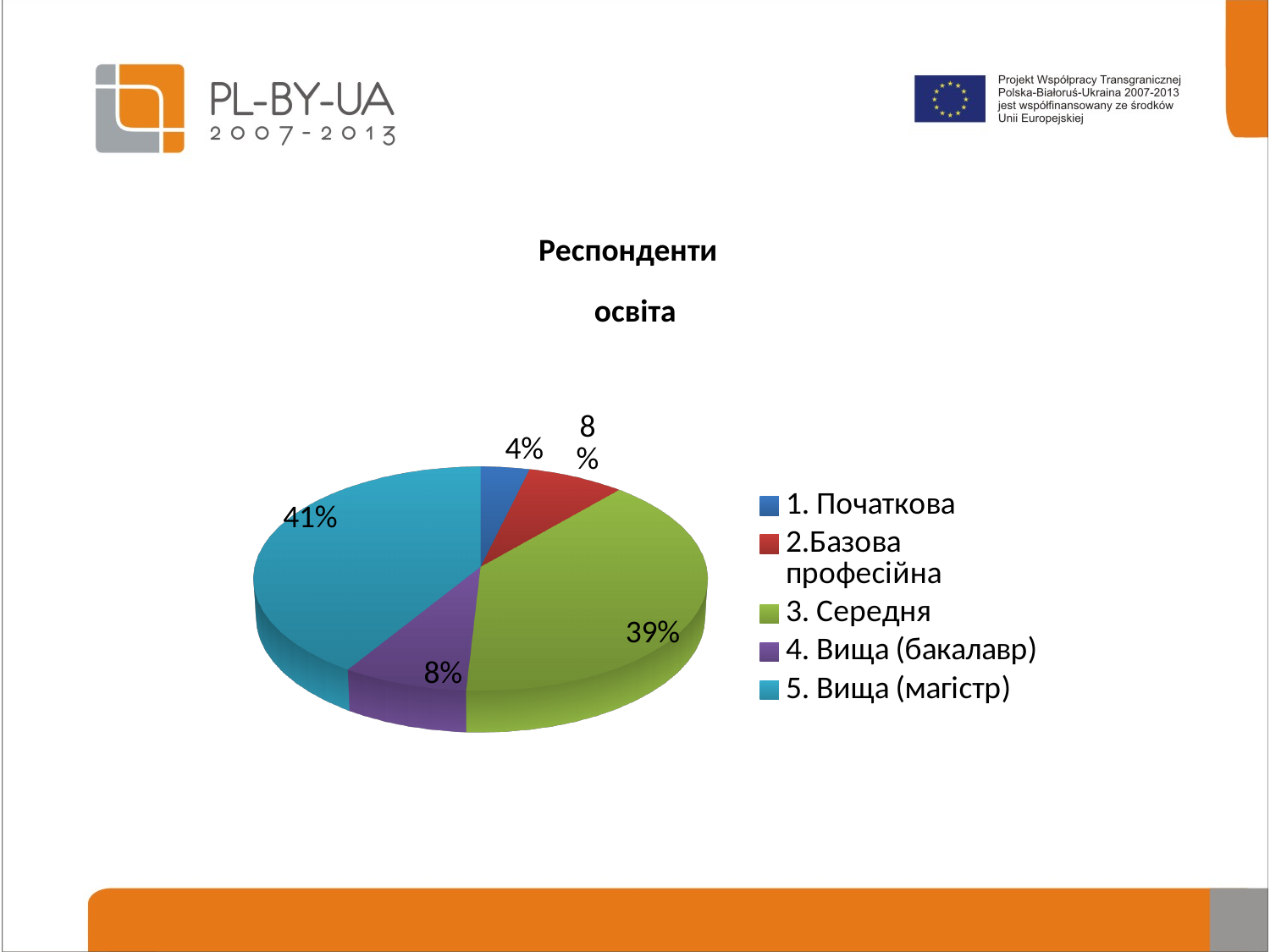
Which is larger: the share for '3. Середня' or for '5. Вища (магістр)'? 5. Вища (магістр) What percentage is shown for '1. Початкова'? 4% Which education category has the largest share of respondents? 5. Вища (магістр) What is the difference in percentage points between '5. Вища (магістр)' and '3. Середня'? 2% What percentage is shown for '2.Базова професійна'? 8% Which education category has the smallest share of respondents? 1. Початкова What percentage is shown for '3. Середня'? 39% What percentage is shown for '4. Вища (бакалавр)'? 8% What is the title of the chart? Респонденти освіта What share of respondents have '5. Вища (магістр)' education? 41% How many categories does the pie chart show? 5 What type of chart is shown on the slide? Pie chart